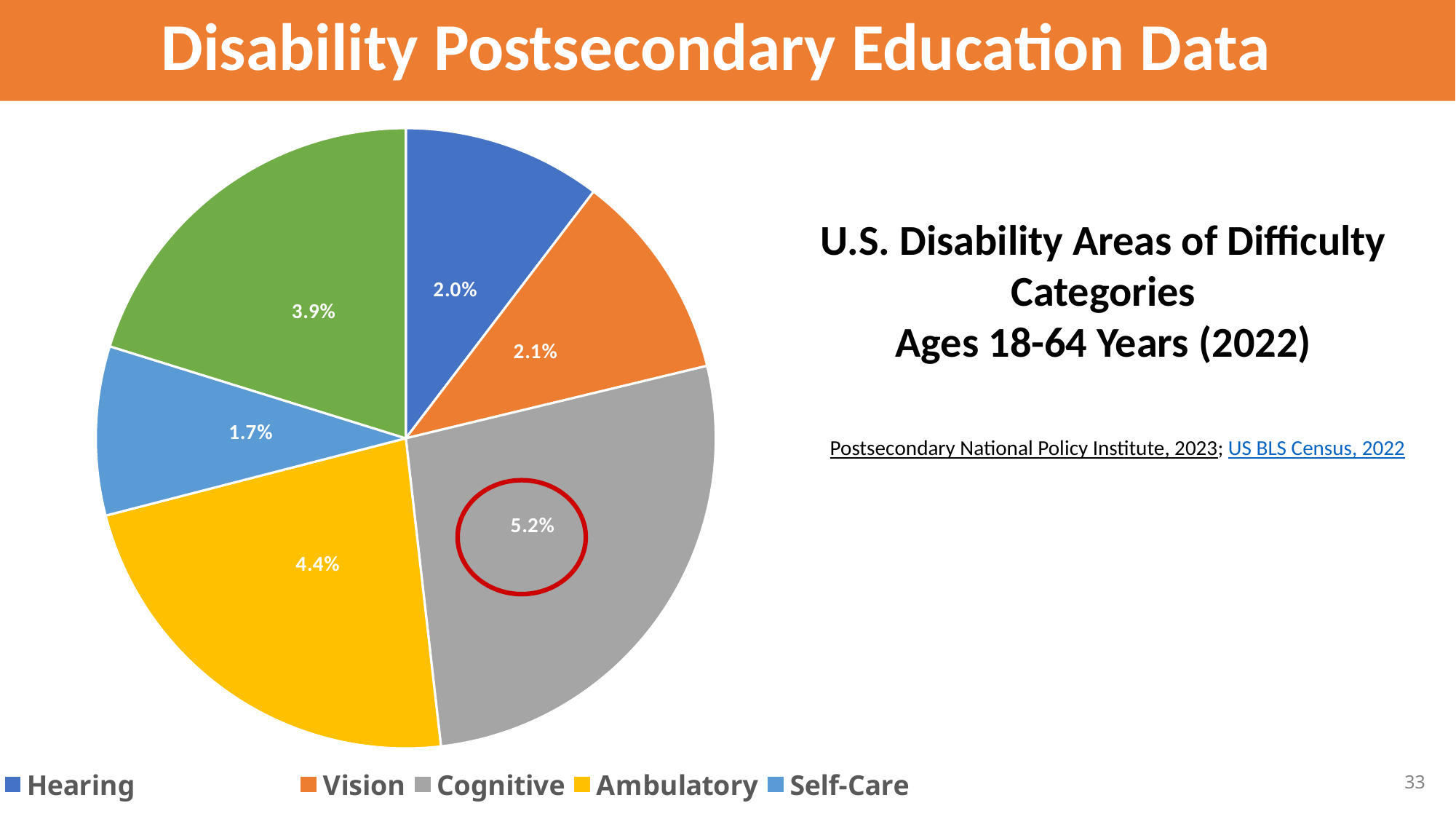
Which legend category has the smallest slice of the pie? Self-Care Which is larger, the Ambulatory slice or the Hearing slice? Ambulatory What is the value shown for the Self-Care slice? 1.7% What is the value shown for the Cognitive slice? 5.2% What type of chart is shown on the slide? Pie chart What is the value shown for the Vision slice? 2.1% Which slice is circled in red on the pie chart? Cognitive (5.2%) What is the value shown for the Hearing slice? 2.0% What is the difference between the Cognitive value and the Ambulatory value? 0.8% How many slices does the pie chart have? 6 Which legend category has the largest slice of the pie? Cognitive What is the value shown for the Ambulatory slice? 4.4%